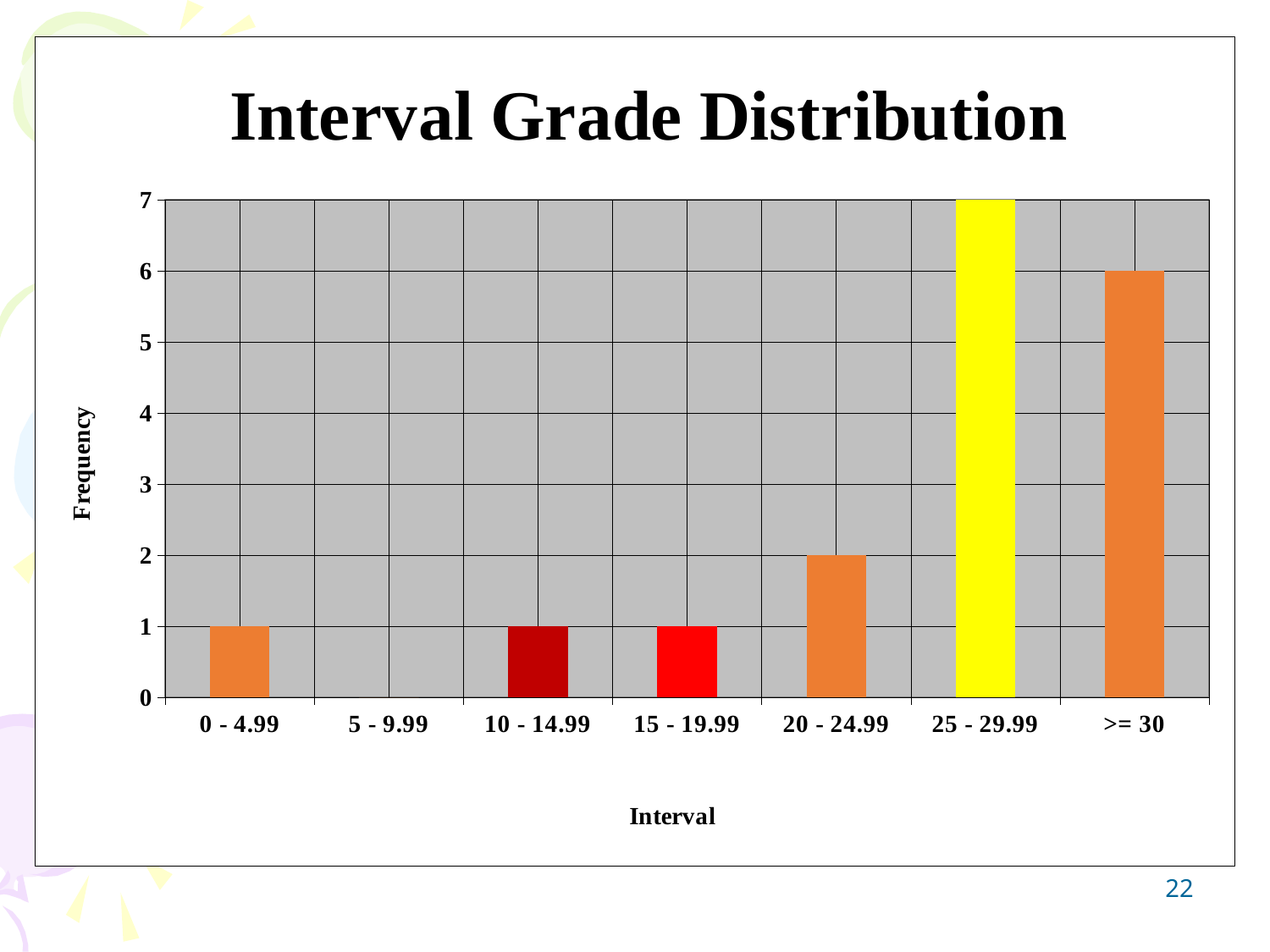
What is the title of the chart? Interval Grade Distribution What kind of chart is shown on the slide? Bar chart Which interval has the highest frequency? 25 - 29.99 Which has a higher frequency, the 20 - 24.99 interval or the 15 - 19.99 interval? 20 - 24.99 What is the frequency for the >= 30 interval? 6 What is the label of the y axis? Frequency What is the frequency for the 20 - 24.99 interval? 2 How many intervals are shown on the x axis? 7 What is the difference in frequency between the 25 - 29.99 interval and the >= 30 interval? 1 What is the frequency for the 25 - 29.99 interval? 7 What is the frequency for the 0 - 4.99 interval? 1 Which interval has no bar shown (a frequency of 0)? 5 - 9.99